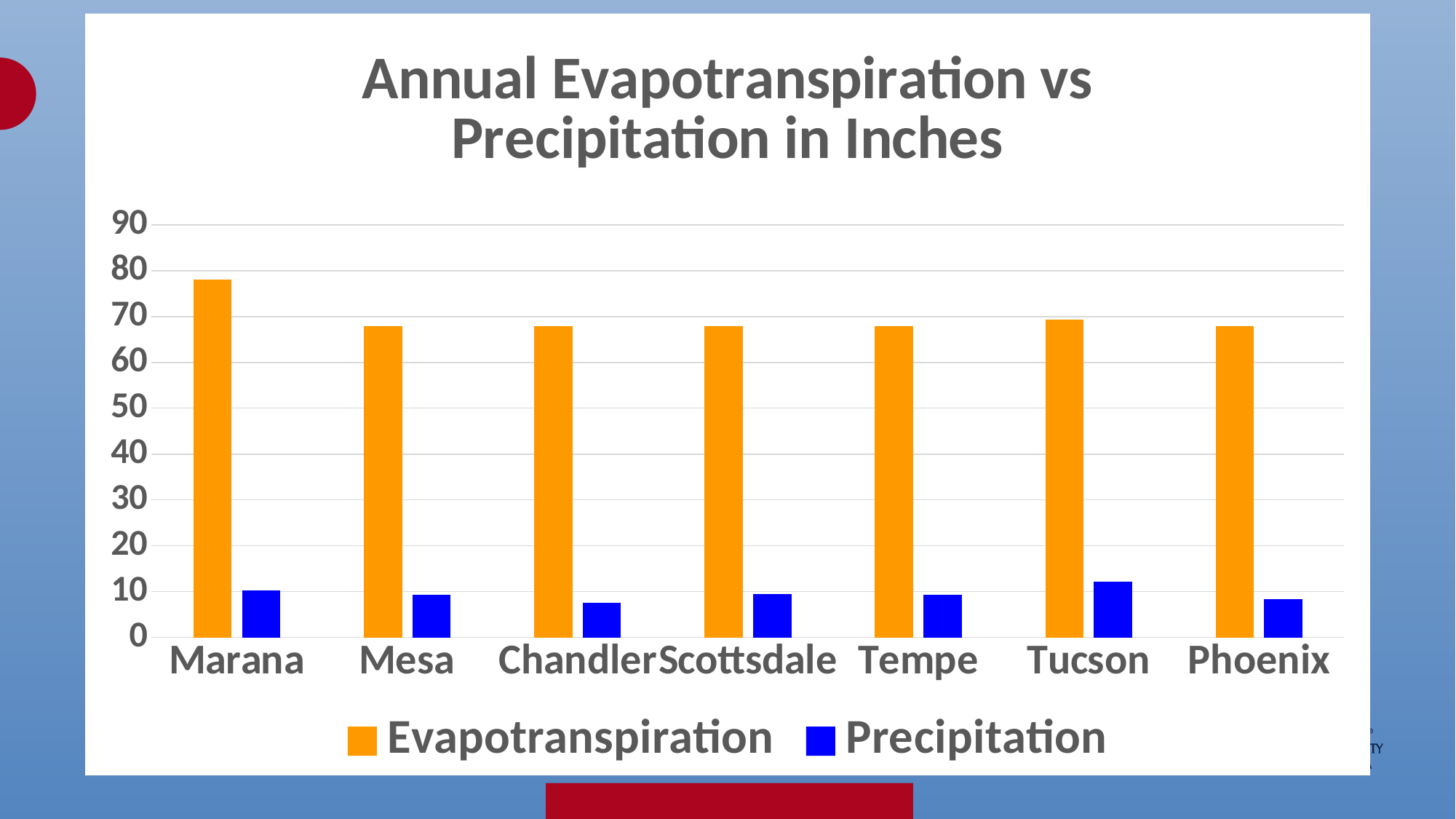
Is the Evapotranspiration value for Marana greater or less than 70? greater Is the Precipitation value for Chandler greater or less than 10? less Which is larger, the Evapotranspiration value for Marana or for Tucson? Marana What colour are the Precipitation bars? blue How many series does the legend list? 2 Is the Evapotranspiration value for Mesa greater or less than 70? less What kind of chart is shown on the slide? bar chart How many cities are shown on the x axis? 7 Which city has the highest Precipitation value? Tucson Which city has the highest Evapotranspiration value? Marana Which is larger, the Precipitation value for Tucson or for Chandler? Tucson